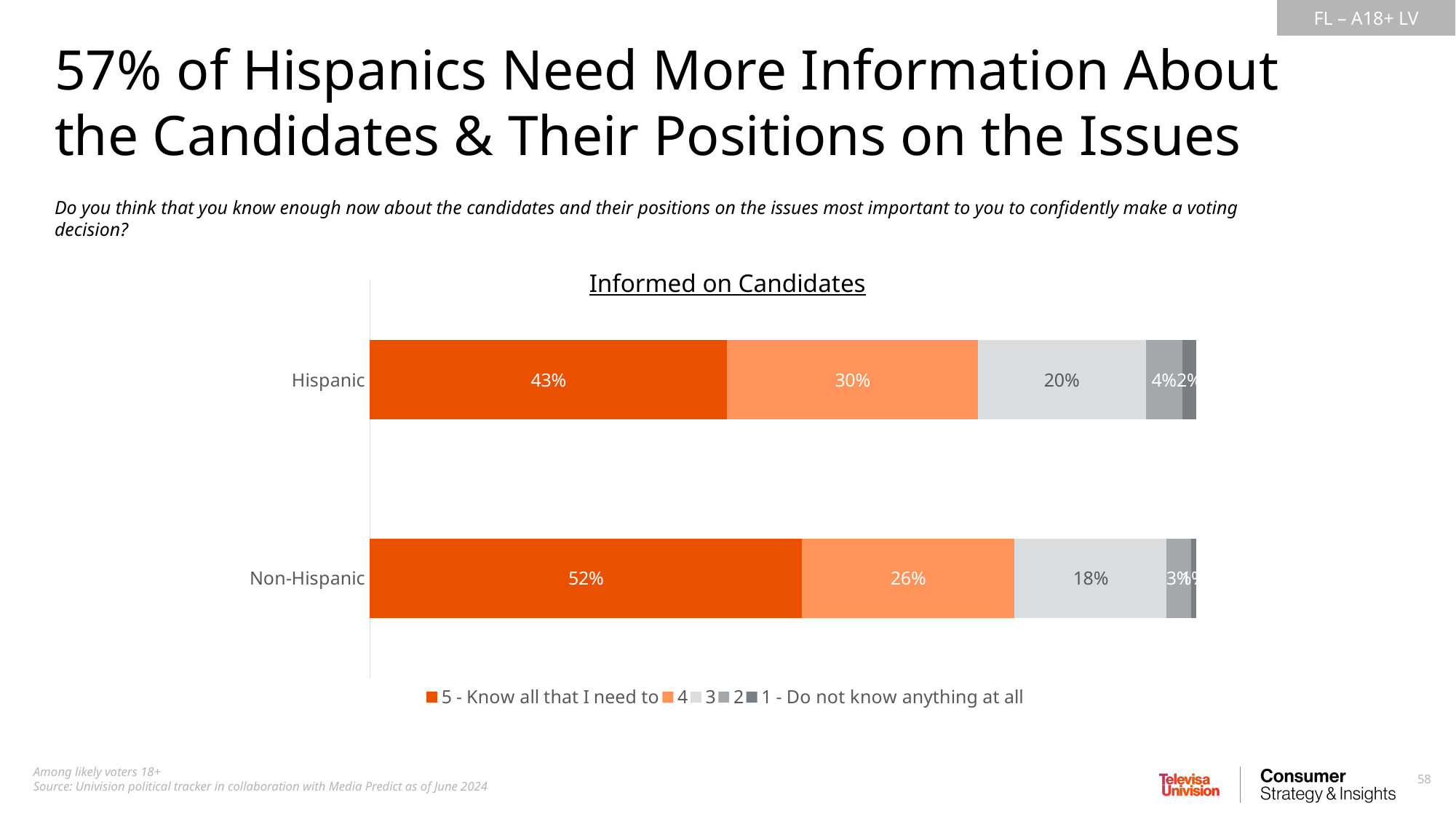
What is the value for the "2" rating in the Hispanic bar? 4% Which group has the larger share answering "5 - Know all that I need to", Hispanic or Non-Hispanic? Non-Hispanic By how many percentage points does the Non-Hispanic "5 - Know all that I need to" share exceed the Hispanic share? 9 percentage points How many series does the legend list? 5 Which rating makes up the largest segment of the Hispanic bar? 5 - Know all that I need to What percentage of Hispanic respondents answered "5 - Know all that I need to"? 43% What is the value for the "3" rating in the Non-Hispanic bar? 18% What is the value for the "4" rating in the Hispanic bar? 30% What type of chart is shown on the slide? Stacked bar chart How many groups (categories) are shown in the chart? 2 What percentage of Non-Hispanic respondents answered "5 - Know all that I need to"? 52% What is the difference between the Hispanic and Non-Hispanic values for the "4" rating? 4 percentage points